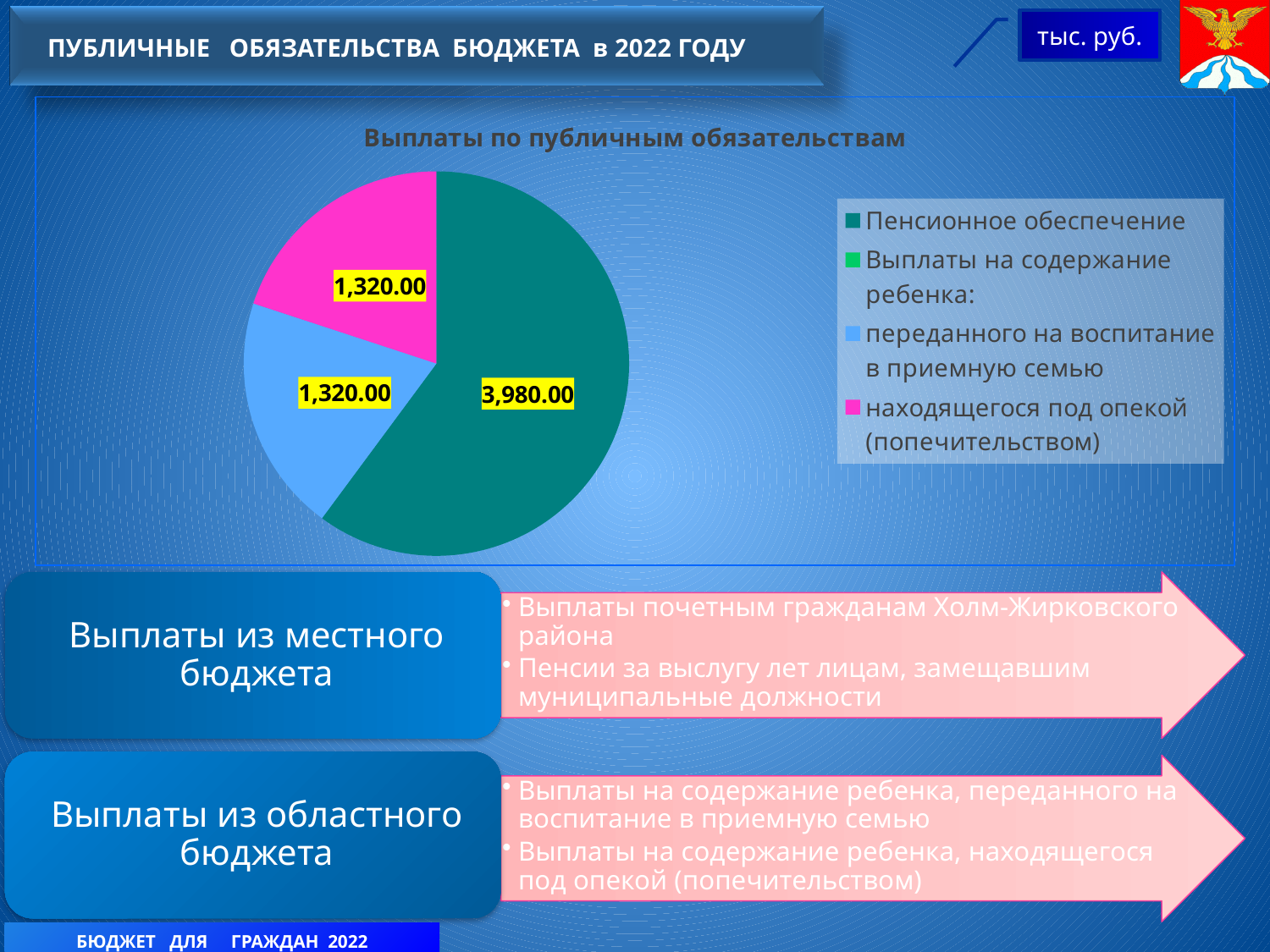
How many slices with data labels are shown in the pie chart? 3 In what units are the values on the slide given? тыс. руб. What is the value for Пенсионное обеспечение in the pie chart? 3,980.00 How many entries does the legend of the pie chart list? 4 What kind of chart is shown on the slide? pie chart What is the value for the slice 'находящегося под опекой (попечительством)'? 1,320.00 Which category has the largest slice in the pie chart? Пенсионное обеспечение What is the value for the slice 'переданного на воспитание в приемную семью'? 1,320.00 What is the difference between the value for Пенсионное обеспечение and the value for 'переданного на воспитание в приемную семью'? 2,660.00 What is the total of the three labelled slices in the pie chart? 6,620.00 What is the title of the pie chart? Выплаты по публичным обязательствам Which is larger: the value for Пенсионное обеспечение or the value for 'находящегося под опекой (попечительством)'? Пенсионное обеспечение